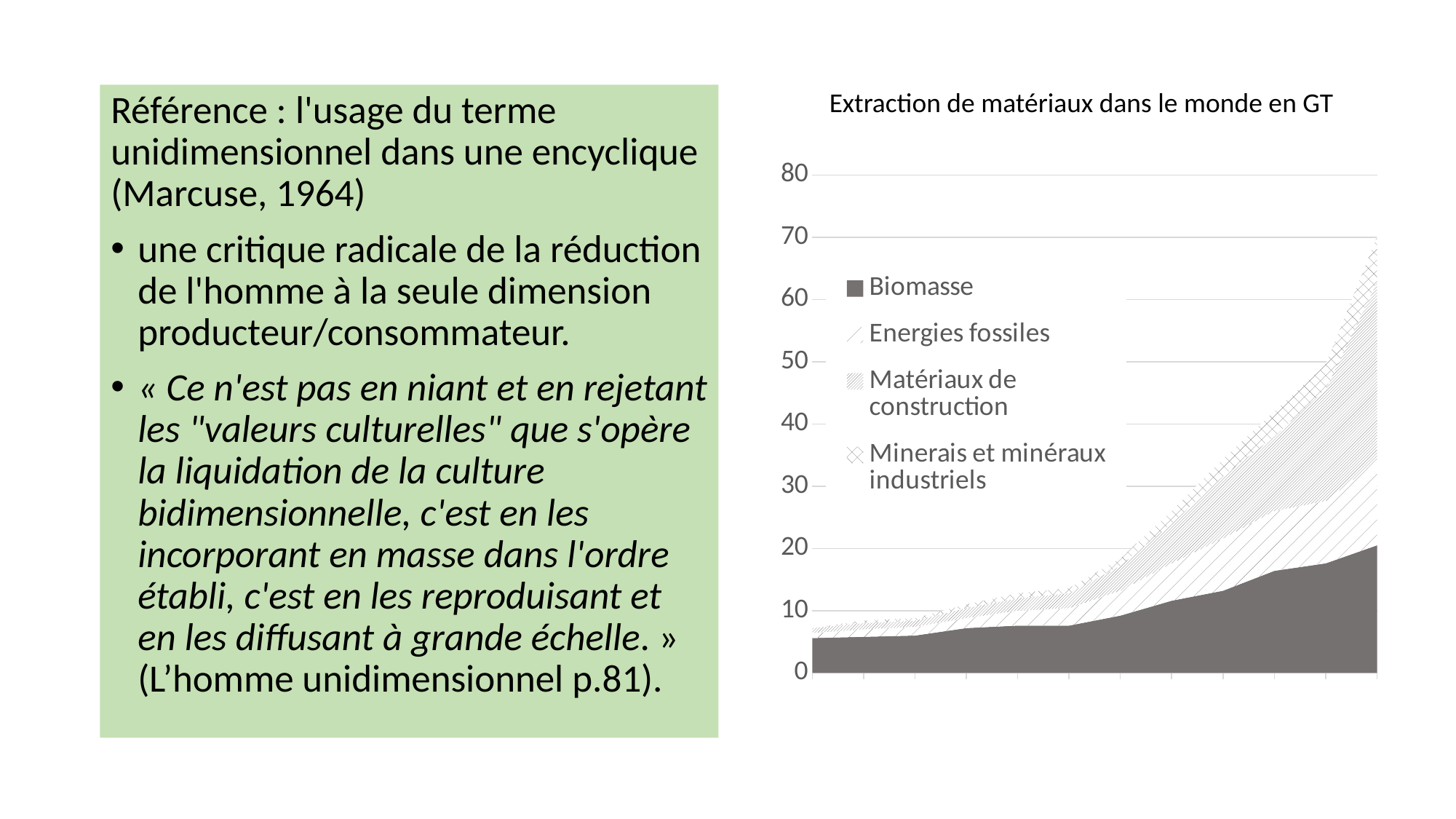
What is the highest value shown on the chart's vertical axis? 80 Is the total extraction at the left end of the chart greater or less than 10? less Is the total extraction at the right end of the chart greater or less than the total at the left end? greater Is the total extraction at the right end of the chart greater or less than 60? greater How many series does the chart's legend list? 4 What is the title of the chart? Extraction de matériaux dans le monde en GT What kind of chart is shown on the slide? Stacked area chart Is the value for Biomasse at the right end of the chart greater or less than 10? greater Which series is shown at the bottom of the stacked areas in the chart? Biomasse Does the total extraction of materials rise or fall from left to right along the x axis? Rise